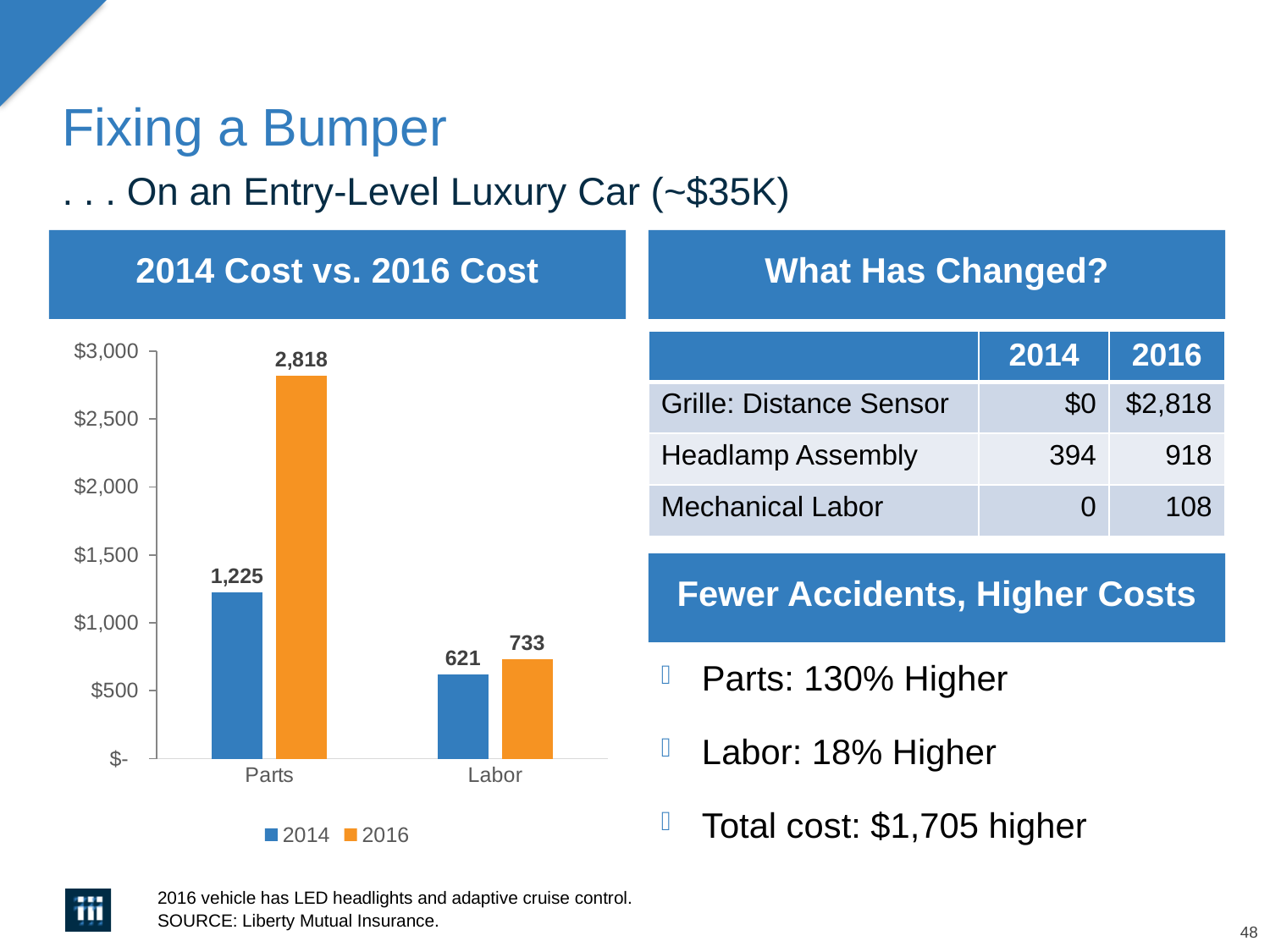
What is the difference between the 2016 and 2014 values for Parts? 1,593 What is the 2014 value for Parts? 1,225 How many series does the legend list? 2 Which bar is the lowest on the chart? Labor, 2014 Which bar is the highest on the chart? Parts, 2016 Which is larger, the 2014 value for Parts or the 2016 value for Labor? 2014 value for Parts What is the difference between the 2016 and 2014 values for Labor? 112 What is the 2016 value for Labor? 733 How many categories are shown on the x axis? 2 What is the 2014 value for Labor? 621 What kind of chart is shown? Bar chart What is the 2016 value for Parts? 2,818